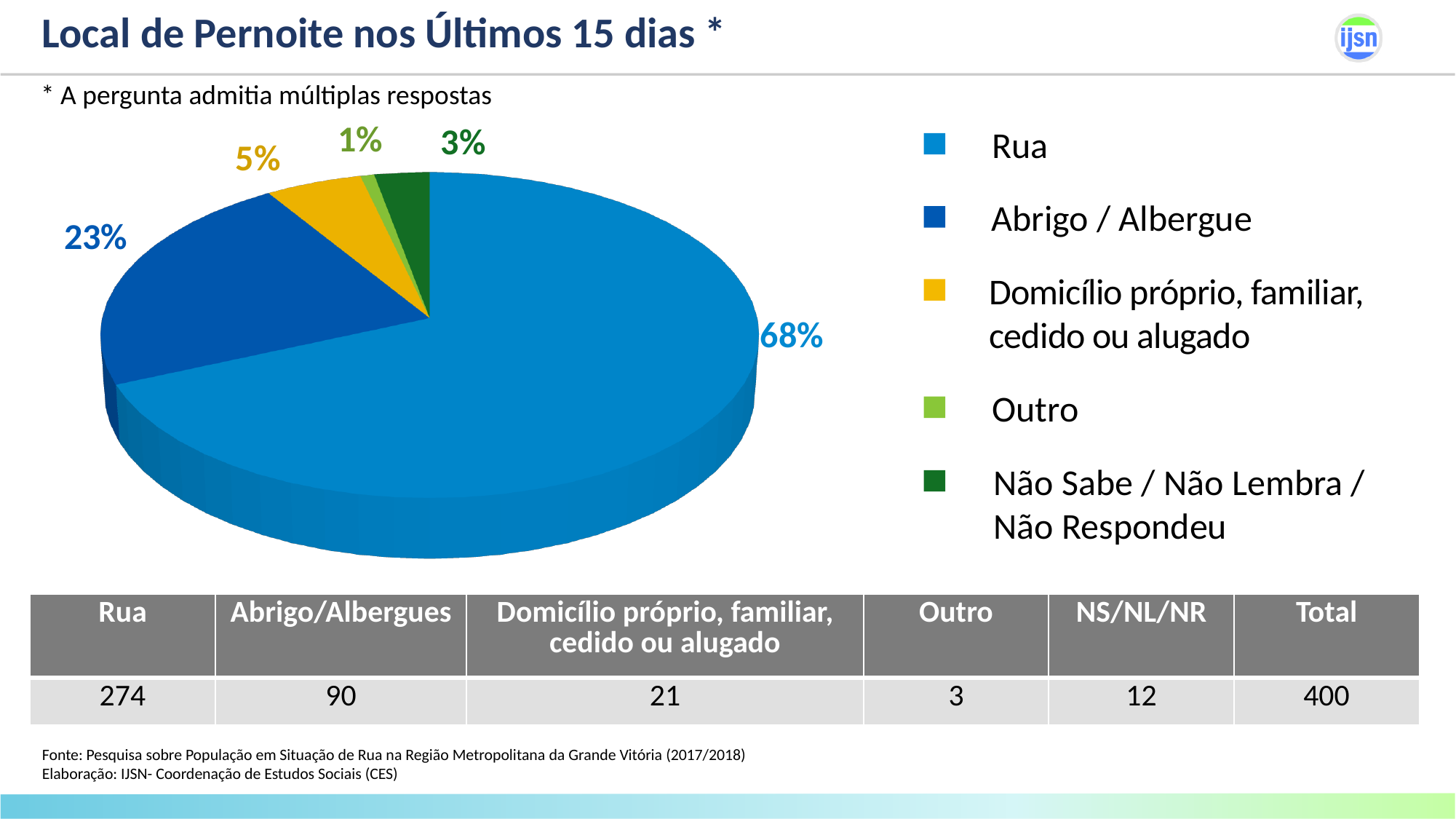
What share of the pie does Abrigo / Albergue represent? 23% What share of the pie does Não Sabe / Não Lembra / Não Respondeu represent? 3% Which slice is larger, Domicílio próprio, familiar, cedido ou alugado or Não Sabe / Não Lembra / Não Respondeu? Domicílio próprio, familiar, cedido ou alugado What is the difference in percentage points between the Rua slice and the Abrigo / Albergue slice? 45 What kind of chart is shown on the slide? Pie chart Which category has the largest slice of the pie? Rua What share of the pie does Domicílio próprio, familiar, cedido ou alugado represent? 5% What is the title of the chart on the slide? Local de Pernoite nos Últimos 15 dias * How many categories does the pie chart show? 5 Which category has the smallest slice of the pie? Outro